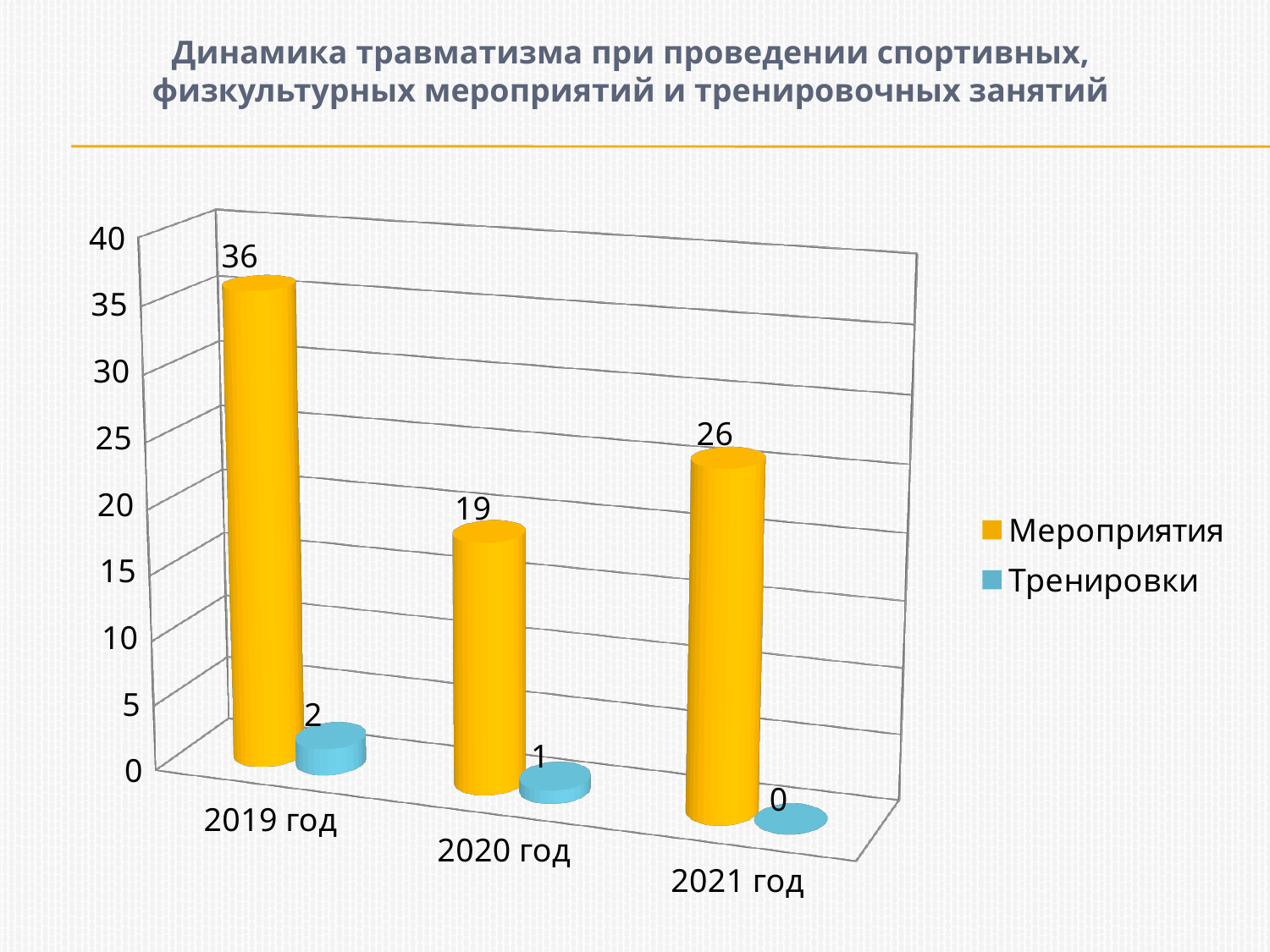
What kind of chart is shown on the slide? Bar chart What is the value for Мероприятия in 2019 год? 36 What is the value for Тренировки in 2021 год? 0 How many years are shown on the x axis? 3 What is the difference between the Мероприятия values for 2019 год and 2020 год? 17 Which is larger: Мероприятия in 2021 год or Мероприятия in 2020 год? Мероприятия in 2021 год Which year has the lowest value for Мероприятия? 2020 год Do the Тренировки values rise or fall from 2019 год to 2021 год? Fall What is the value for Тренировки in 2020 год? 1 Which year has the highest value for Мероприятия? 2019 год How many series does the legend list? 2 What is the value for Мероприятия in 2021 год? 26